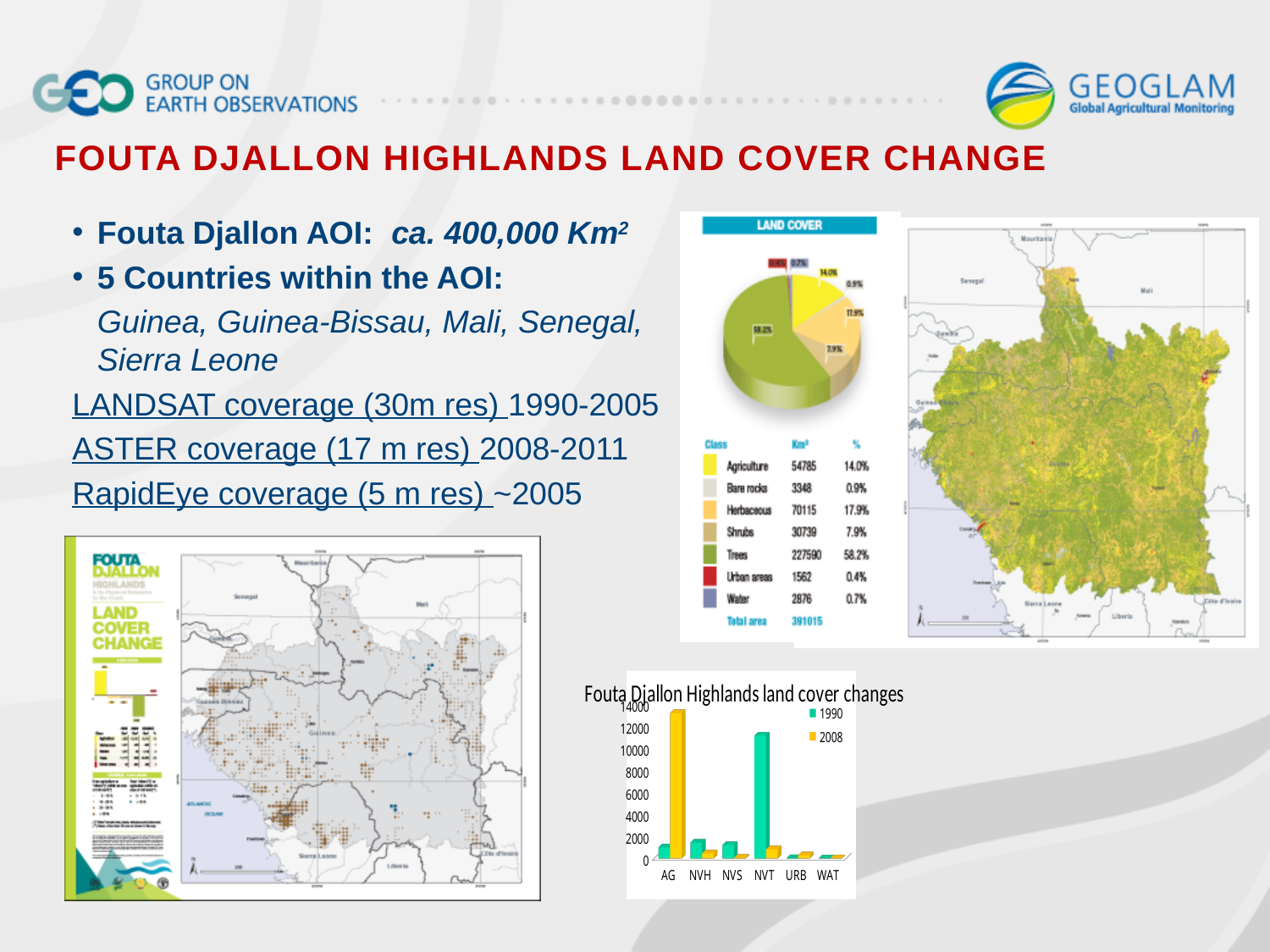
In the 'Fouta Djallon Highlands land cover changes' bar chart, which is larger for AG: the 1990 value or the 2008 value? 2008 In the 'Fouta Djallon Highlands land cover changes' bar chart, which category has the tallest bar for the 2008 series? AG In the 'Fouta Djallon Highlands land cover changes' bar chart, is the 1990 value for NVH greater or less than 4000? less How many series does the legend of the 'Fouta Djallon Highlands land cover changes' bar chart list? 2 In the 'Fouta Djallon Highlands land cover changes' bar chart, which is larger for NVT: the 1990 value or the 2008 value? 1990 In the 'Fouta Djallon Highlands land cover changes' bar chart, is the 2008 value for AG greater or less than 12000? greater How many categories are shown on the x axis of the 'Fouta Djallon Highlands land cover changes' bar chart? 6 In the 'LAND COVER' pie chart at the top right of the slide, what share does the largest slice have? 58.2% What kind of chart is the 'Fouta Djallon Highlands land cover changes' chart at the bottom right of the slide? bar chart In the 'Fouta Djallon Highlands land cover changes' bar chart, which category has the tallest bar for the 1990 series? NVT What are the two series named in the legend of the 'Fouta Djallon Highlands land cover changes' bar chart? 1990 and 2008 In the 'Fouta Djallon Highlands land cover changes' bar chart, is the 1990 value for NVT greater or less than 10000? greater